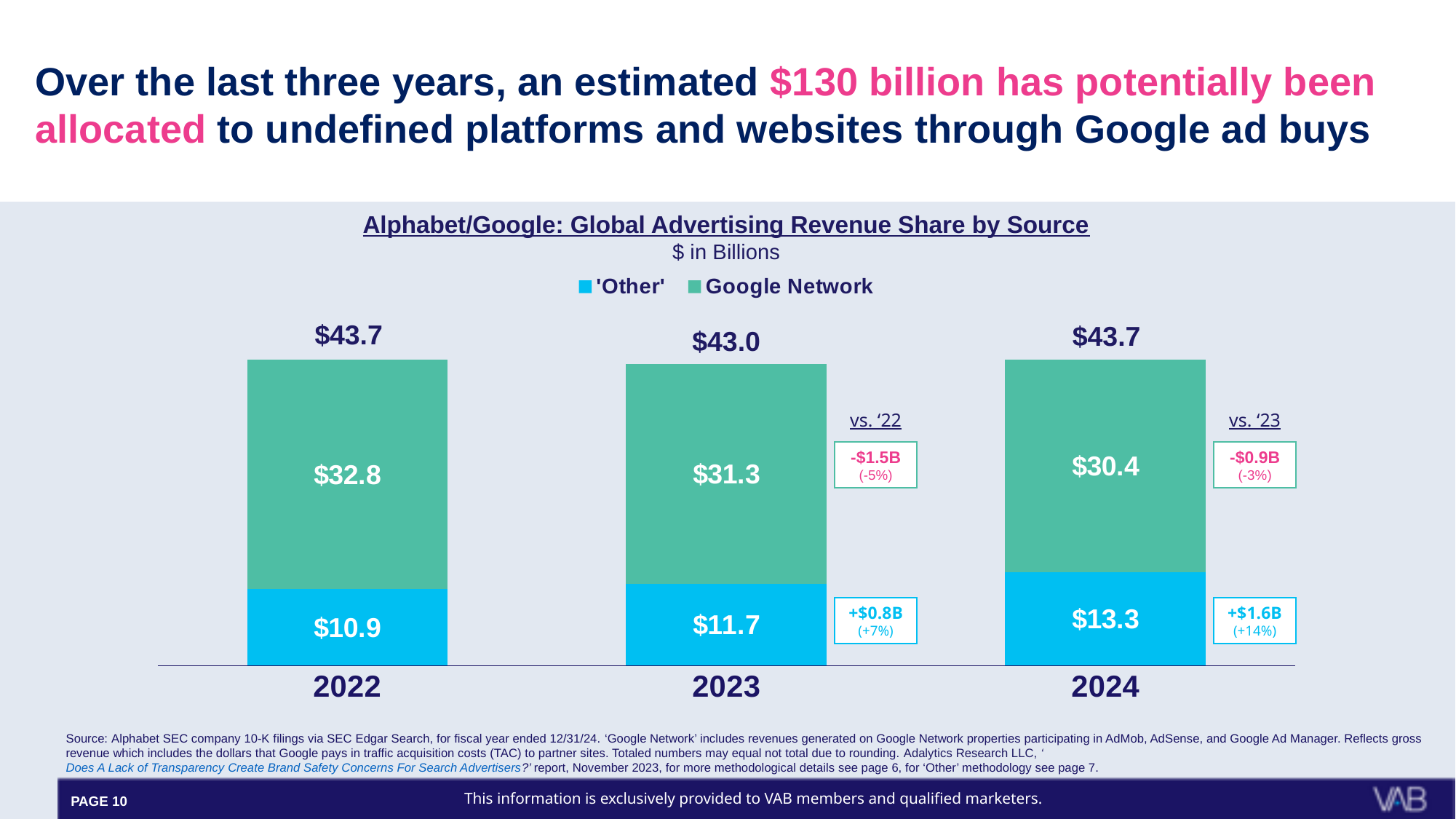
What is the 'Other' value for 2022? $10.9 How many years are shown on the x axis? 3 How many series does the legend list? 2 Do the 'Other' values rise or fall from 2022 to 2024? Rise What kind of chart is shown? Stacked bar chart What is the total of the stacked bar for 2023? $43.0 Which is larger, the 'Other' value for 2023 or the 'Other' value for 2024? 2024 What is the title of the chart? Alphabet/Google: Global Advertising Revenue Share by Source What is the difference between the Google Network values for 2022 and 2023? $1.5 Which year has the lowest Google Network value? 2024 What is the Google Network value for 2024? $30.4 Which year has the highest 'Other' value? 2024